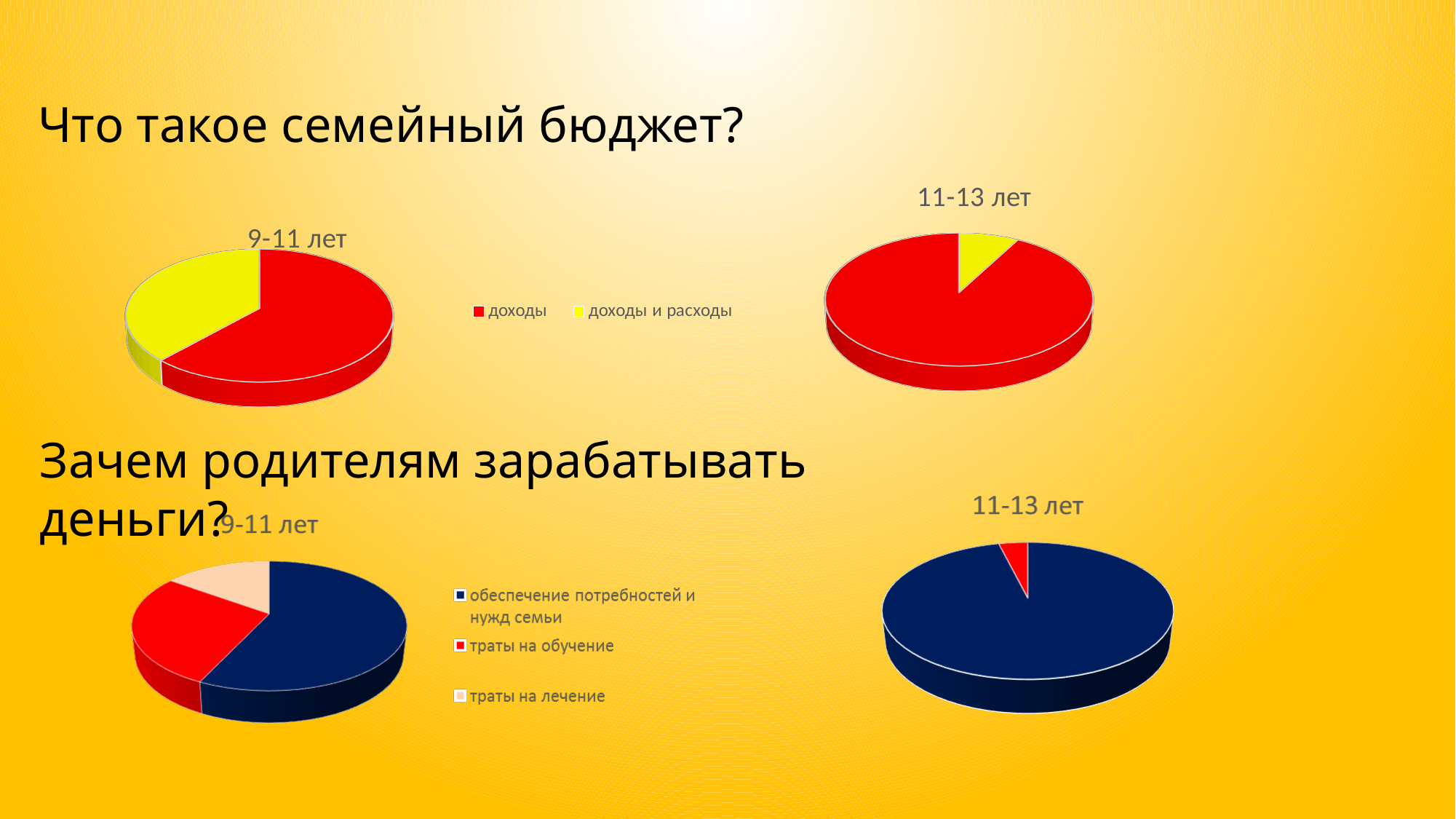
In the bottom-left pie chart (9-11 лет, under "Зачем родителям зарабатывать деньги?"), which category has the largest share? обеспечение потребностей и нужд семьи How many categories does the legend list for the bottom row of pie charts under "Зачем родителям зарабатывать деньги?"? 3 What kind of chart is the top-left chart titled "9-11 лет" under "Что такое семейный бюджет?"? Pie chart In the top-left pie chart (9-11 лет, under "Что такое семейный бюджет?"), which category has the largest share? доходы In the bottom-right pie chart (11-13 лет, under "Зачем родителям зарабатывать деньги?"), which category has the largest share? обеспечение потребностей и нужд семьи In the bottom-left pie chart (9-11 лет, under "Зачем родителям зарабатывать деньги?"), is the share for "траты на обучение" larger or smaller than the share for "траты на лечение"? larger What colour represents "доходы" in the top row of pie charts? Red In the bottom-left pie chart (9-11 лет, under "Зачем родителям зарабатывать деньги?"), which category has the smallest share? траты на лечение In the top-left pie chart (9-11 лет, under "Что такое семейный бюджет?"), which category has the smallest share? доходы и расходы How many categories does the legend list for the top row of pie charts under "Что такое семейный бюджет?"? 2